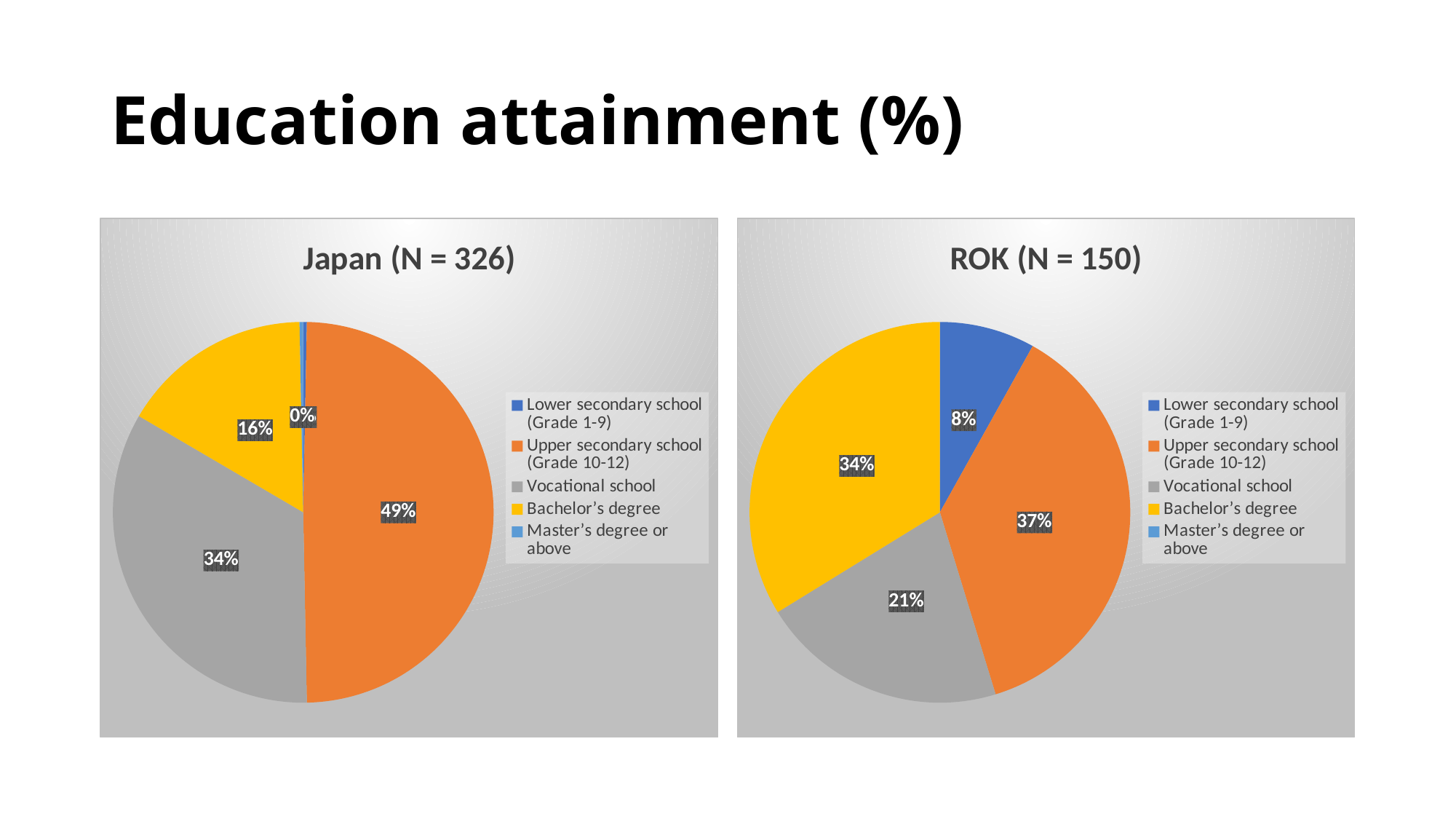
In the ROK (N = 150) chart, which category has the largest slice? Upper secondary school (Grade 10-12) In the Japan (N = 326) chart, what share is Vocational school? 34% In the ROK (N = 150) chart, what share is Bachelor's degree? 34% In the ROK (N = 150) chart, what is the difference between the Upper secondary school (Grade 10-12) share and the Vocational school share? 16% In the ROK (N = 150) chart, what share is Vocational school? 21% Which chart has the larger Bachelor's degree share, Japan (N = 326) or ROK (N = 150)? ROK (N = 150) In the ROK (N = 150) chart, what share is Upper secondary school (Grade 10-12)? 37% In the Japan (N = 326) chart, what share is Bachelor's degree? 16% What type of chart is used for Japan (N = 326)? Pie chart In the Japan (N = 326) chart, what share is Upper secondary school (Grade 10-12)? 49% In the ROK (N = 150) chart, what share is Lower secondary school (Grade 1-9)? 8% In the Japan (N = 326) chart, which category has the largest slice? Upper secondary school (Grade 10-12)